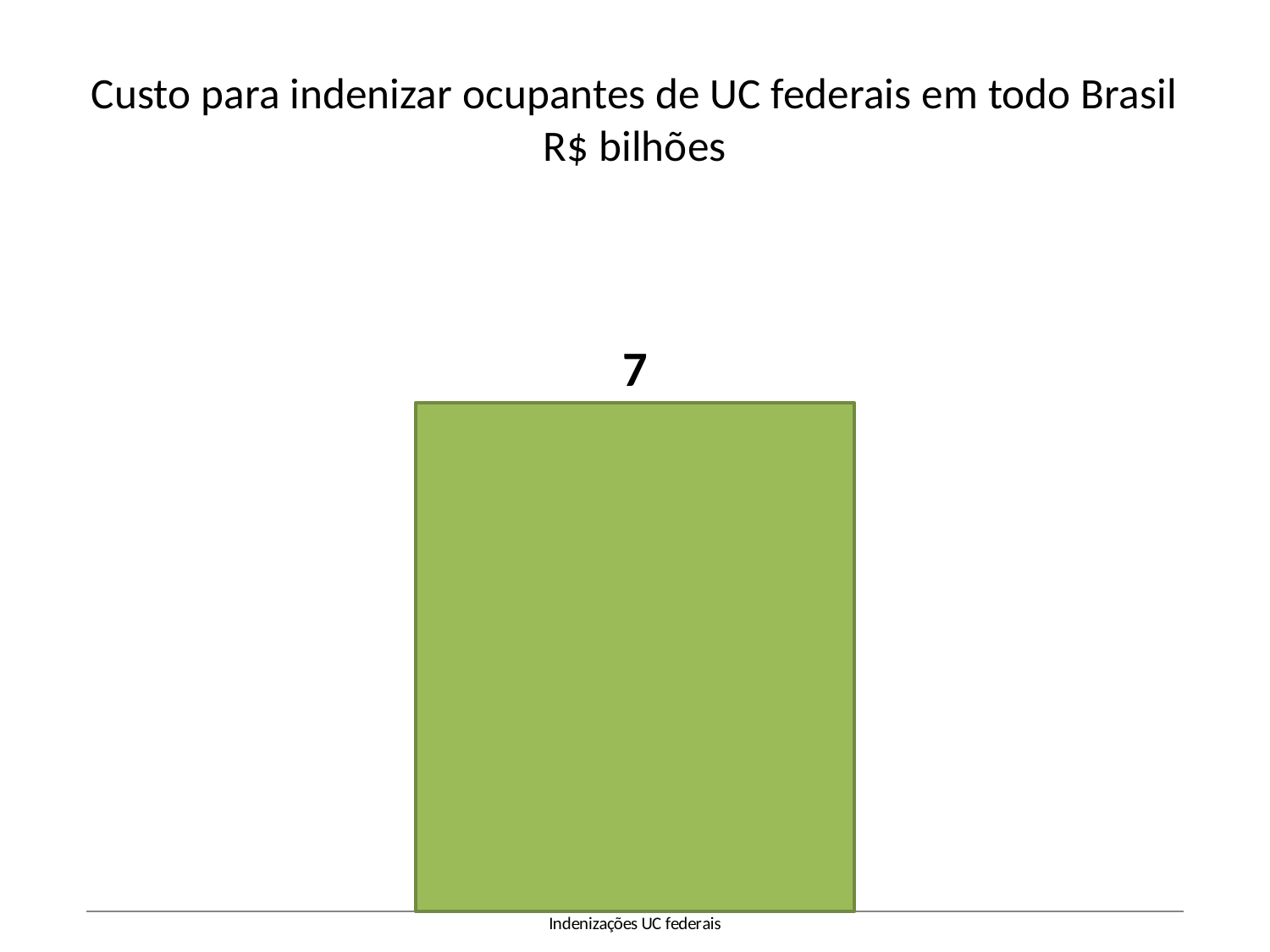
What is the value shown for Indenizações UC federais? 7 What is the title of the chart? Custo para indenizar ocupantes de UC federais em todo Brasil R$ bilhões How many bars does the chart show? 1 What unit does the chart title state the values are in? R$ bilhões What kind of chart is shown on the slide? bar chart What is the label of the category on the x axis? Indenizações UC federais